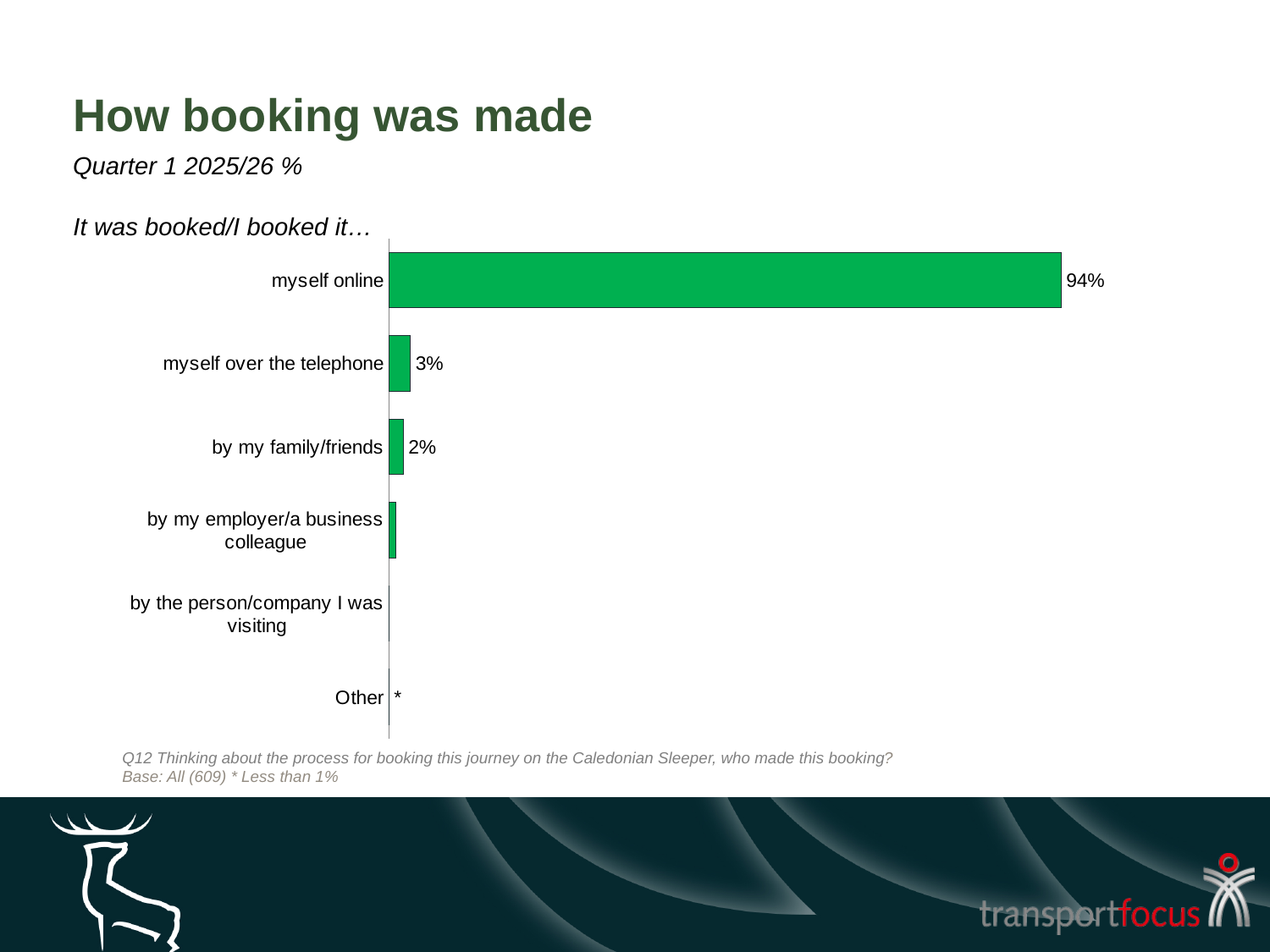
What is the difference in percentage points between 'myself over the telephone' and 'by my family/friends'? 1 Which booking method has the highest percentage? myself online What does the asterisk (*) next to 'Other' indicate? Less than 1% What type of chart is shown on the slide? bar chart What percentage of bookings were made 'myself online'? 94% What is the base size stated for the chart? All (609) What percentage of bookings were made 'myself over the telephone'? 3% What is the title of the chart on the slide? How booking was made Which is larger: the value for 'myself over the telephone' or 'by my family/friends'? myself over the telephone What is the difference in percentage points between 'myself online' and 'myself over the telephone'? 91 What percentage of bookings were made 'by my family/friends'? 2% How many booking method categories are shown on the chart? 6